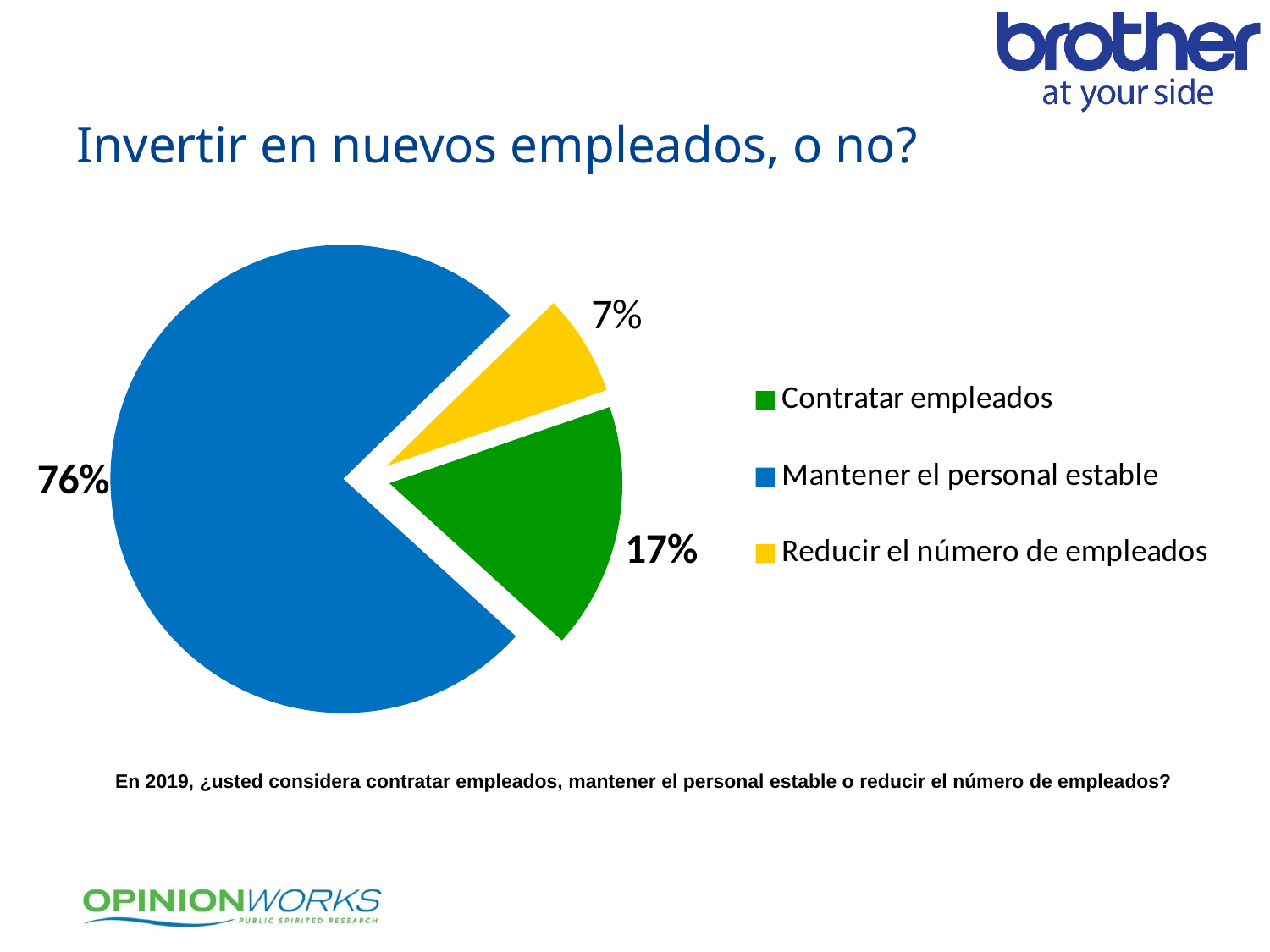
What is the difference in percentage points between Contratar empleados and Reducir el número de empleados? 10 Which is larger: the share for Contratar empleados or the share for Reducir el número de empleados? Contratar empleados What percentage of respondents plan to reduce the number of employees (Reducir el número de empleados)? 7% What is the title of the slide containing the chart? Invertir en nuevos empleados, o no? What colour is the slice for Contratar empleados? Green What is the difference in percentage points between Mantener el personal estable and Contratar empleados? 59 Which category has the smallest share of the pie? Reducir el número de empleados How many slices does the pie chart have? 3 What kind of chart is shown on the slide? Pie chart What percentage of respondents plan to keep staffing stable (Mantener el personal estable)? 76% What percentage of respondents plan to hire employees (Contratar empleados)? 17% Which category has the largest share of the pie? Mantener el personal estable